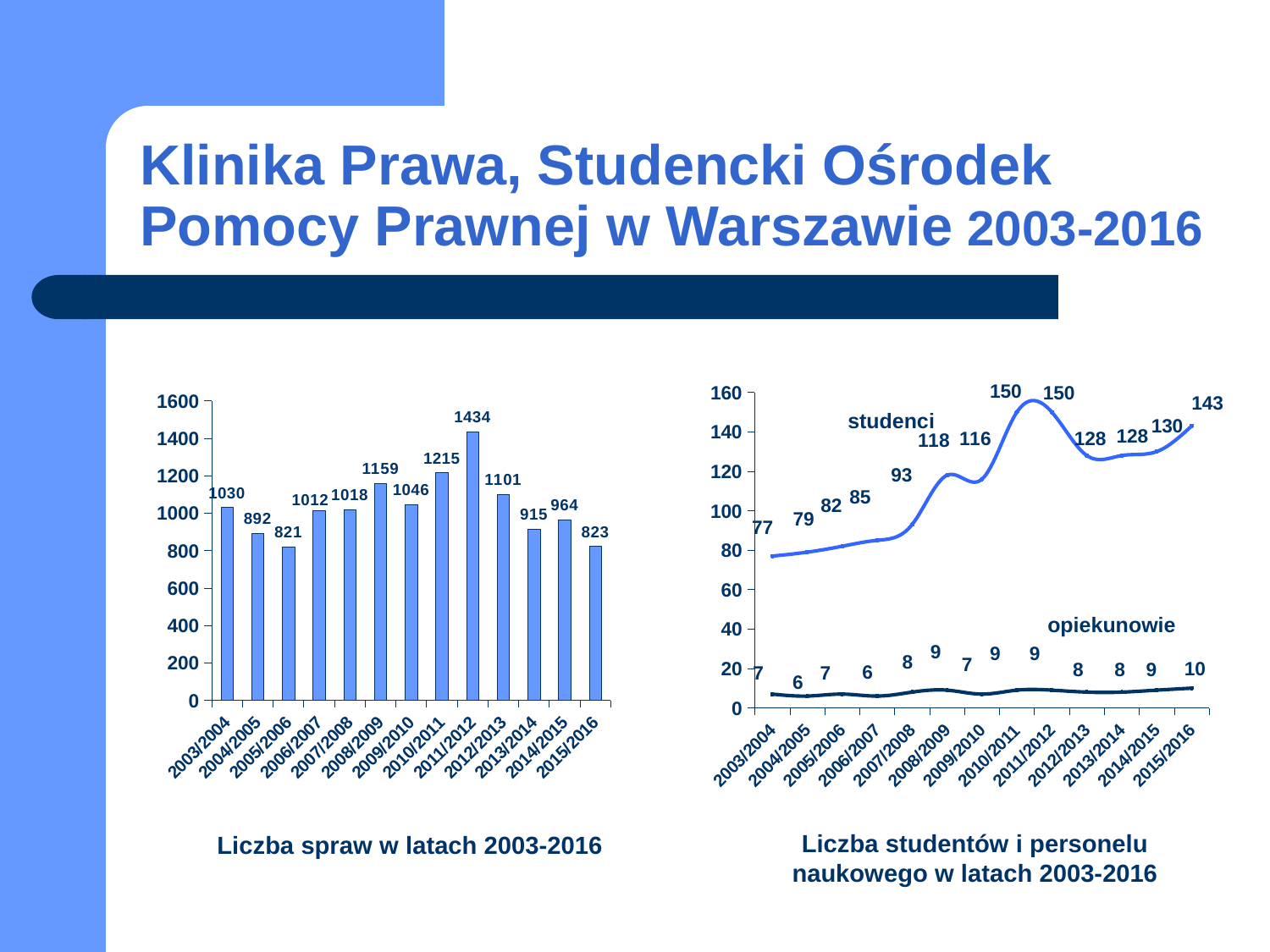
In the chart 'Liczba studentów i personelu naukowego w latach 2003-2016', what is the value for studenci in 2015/2016? 143 In the chart 'Liczba spraw w latach 2003-2016', how many years are shown on the x axis? 13 In the chart 'Liczba studentów i personelu naukowego w latach 2003-2016', what is the difference between studenci and opiekunowie in 2003/2004? 70 In the chart 'Liczba studentów i personelu naukowego w latach 2003-2016', how many series are plotted? 2 In the chart 'Liczba spraw w latach 2003-2016', what is the value for 2011/2012? 1434 What kind of chart is 'Liczba studentów i personelu naukowego w latach 2003-2016'? line chart In the chart 'Liczba spraw w latach 2003-2016', which year has the highest value? 2011/2012 In the chart 'Liczba spraw w latach 2003-2016', which year has the lowest value? 2005/2006 What kind of chart is 'Liczba spraw w latach 2003-2016'? bar chart In the chart 'Liczba studentów i personelu naukowego w latach 2003-2016', is the value for studenci in 2007/2008 larger than in 2008/2009? No In the chart 'Liczba spraw w latach 2003-2016', what is the difference between the values for 2011/2012 and 2012/2013? 333 In the chart 'Liczba studentów i personelu naukowego w latach 2003-2016', what is the value for opiekunowie in 2004/2005? 6